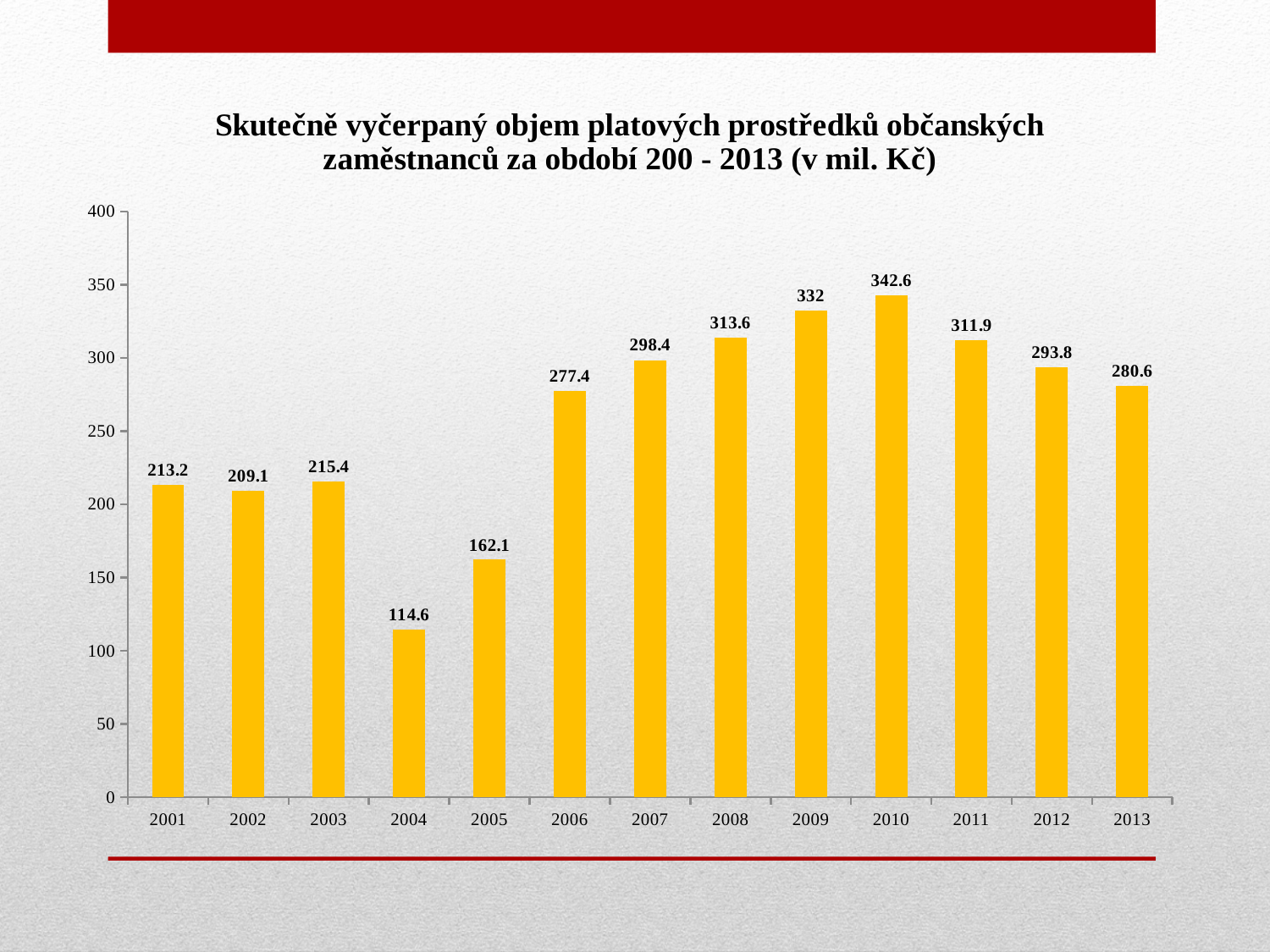
What is the value for 2010? 342.6 How many years are shown on the x axis? 13 Which is larger, the value for 2009 or the value for 2011? 2009 Is the value for 2007 greater or less than 250? greater Which year has the lowest value? 2004 Which year has the highest value? 2010 What is the value for 2004? 114.6 What is the value for 2013? 280.6 What is the difference between the values for 2006 and 2005? 115.3 What is the difference between the values for 2010 and 2004? 228 What kind of chart is this? bar chart Do the values rise or fall from 2010 to 2013? fall